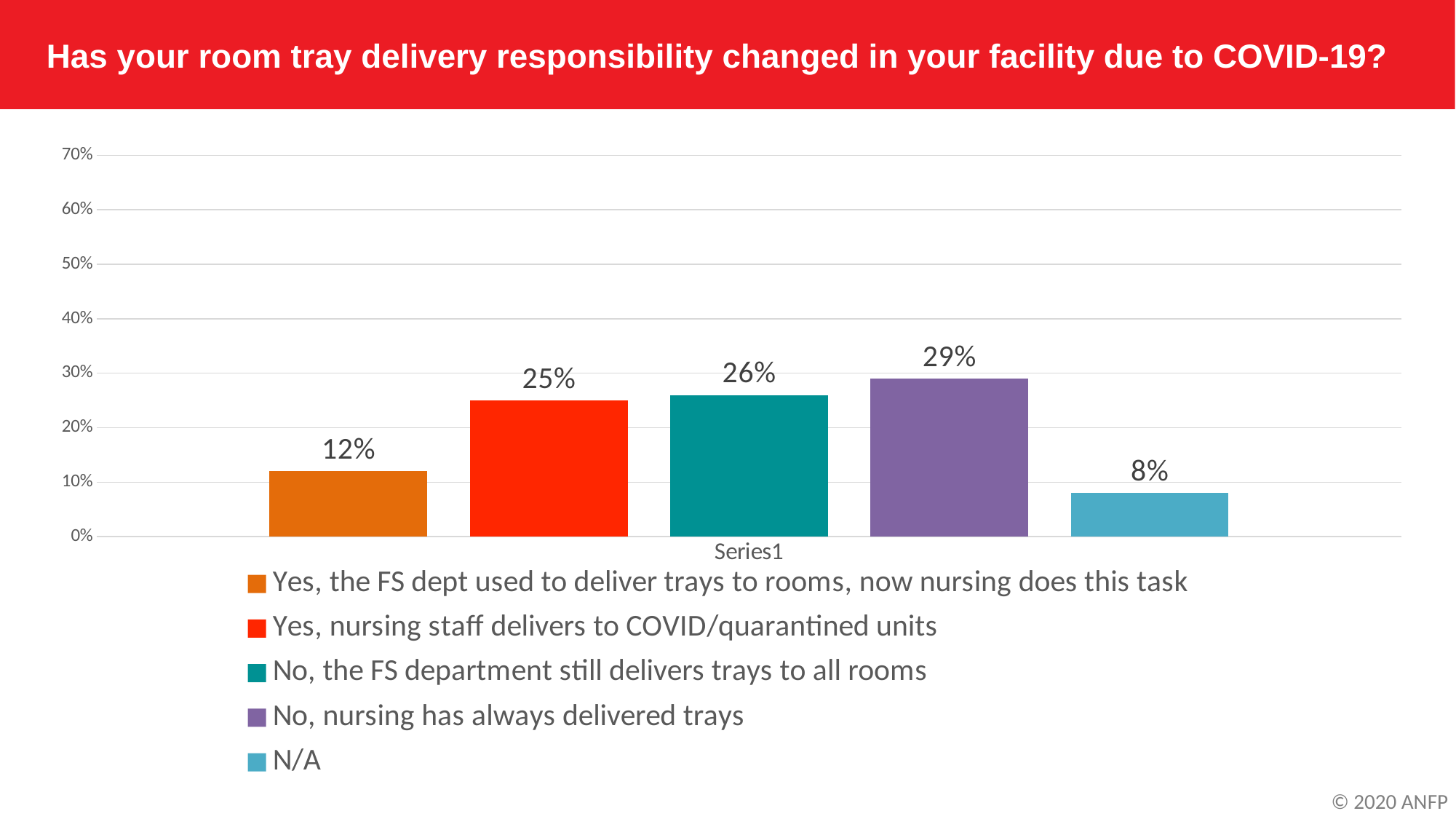
What percentage of respondents answered "Yes, the FS dept used to deliver trays to rooms, now nursing does this task"? 12% What kind of chart is shown on the slide? bar chart What is the value for "Yes, nursing staff delivers to COVID/quarantined units"? 25% Is the value for "No, nursing has always delivered trays" greater or less than 40%? less What percentage answered "N/A"? 8% Which is larger: "Yes, nursing staff delivers to COVID/quarantined units" or "N/A"? Yes, nursing staff delivers to COVID/quarantined units Which response has the highest percentage? No, nursing has always delivered trays How many response categories are shown in the chart? 5 What is the value for "No, the FS department still delivers trays to all rooms"? 26% What is the difference between "No, nursing has always delivered trays" and "Yes, the FS dept used to deliver trays to rooms, now nursing does this task"? 17% Which response has the lowest percentage? N/A What colour is the bar for "No, the FS department still delivers trays to all rooms"? teal